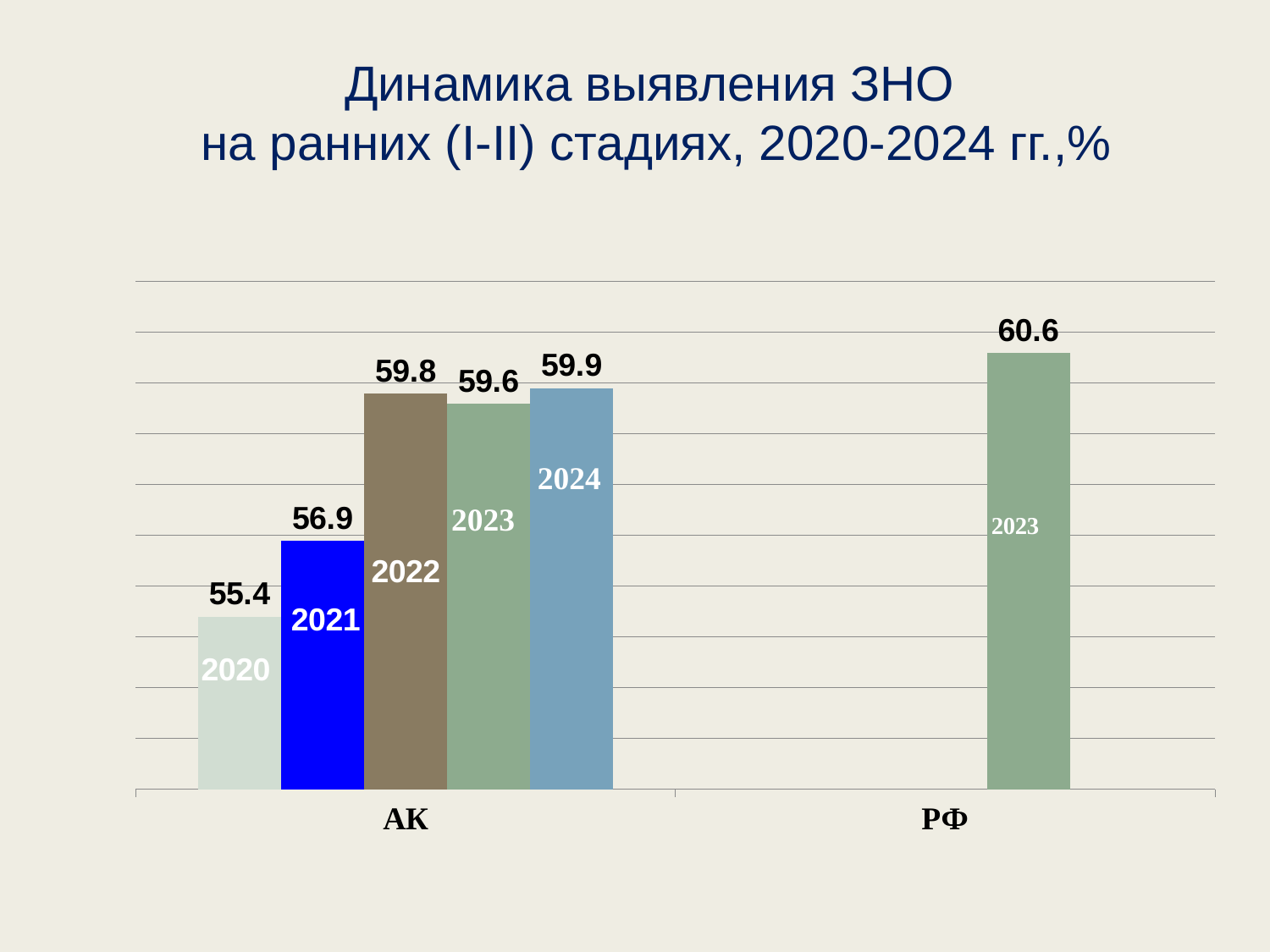
What is the value for АК in 2024? 59.9 Which year has the lowest value for АК? 2020 What is the difference between the АК value in 2024 and the АК value in 2020? 4.5 Which is larger: the АК value in 2021 or the АК value in 2022? 2022 What is the value for АК in 2022? 59.8 What is the value for АК in 2020? 55.4 Which bar on the chart has the highest value? РФ 2023 (60.6) What is the value shown for РФ in 2023? 60.6 What is the value for АК in 2021? 56.9 What kind of chart is shown on the slide? Bar chart How many bars are shown for the АК category? 5 What is the difference between the РФ 2023 value and the АК 2023 value? 1.0